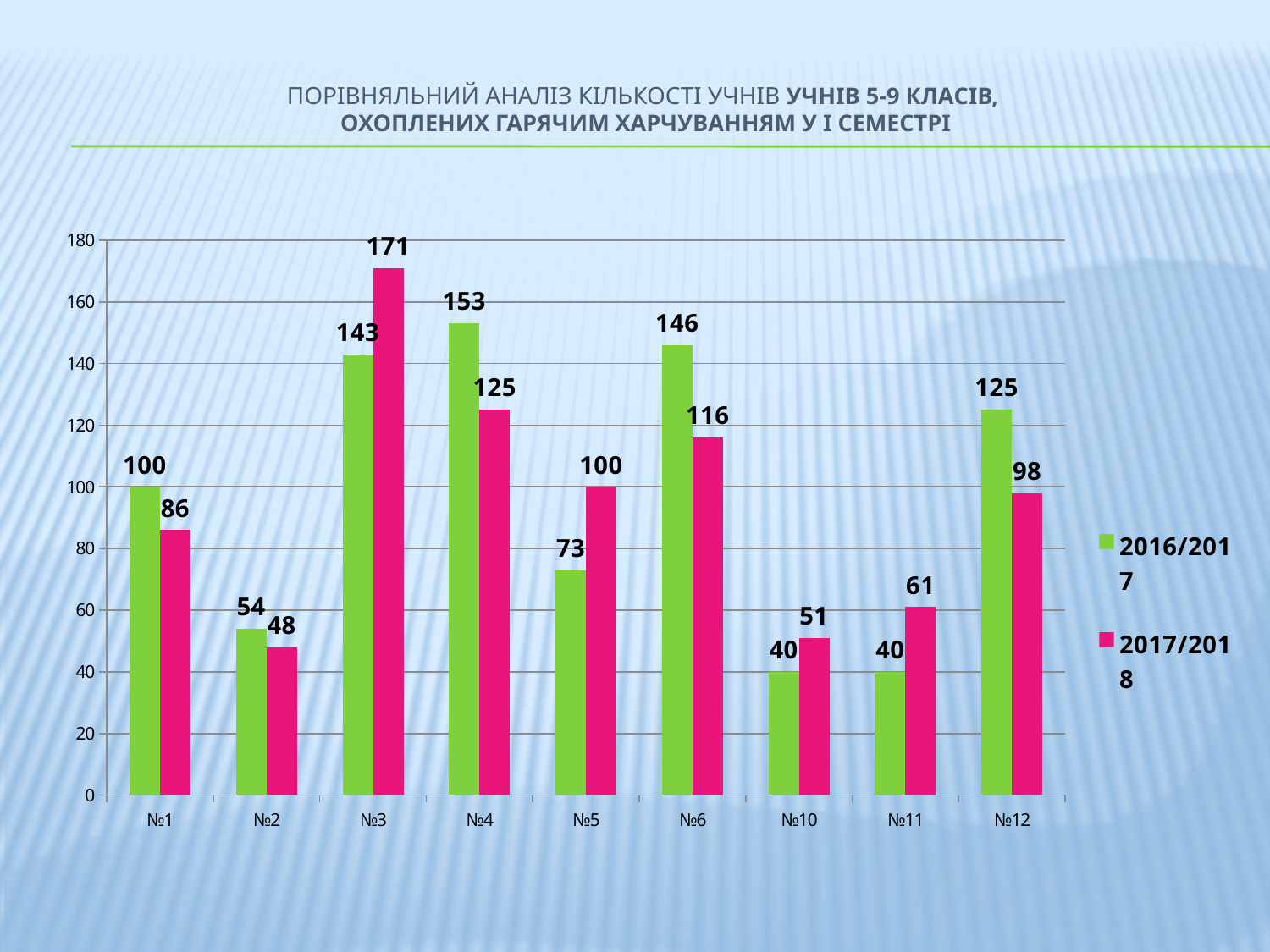
How many categories are shown on the x axis? 9 What kind of chart is shown on the slide? bar chart How many series does the legend list? 2 Which category has the lowest value in the 2017/2018 series? №2 What is the value for №6 in the 2016/2017 series? 146 Which colour represents the 2017/2018 series? pink What is the value for №3 in the 2017/2018 series? 171 What is the value for №12 in the 2017/2018 series? 98 Is the value for №3 in the 2017/2018 series greater or less than 160? greater What is the difference between the 2016/2017 and 2017/2018 values for №4? 28 Which category has the highest value in the 2016/2017 series? №4 Which is larger for №5: the 2016/2017 value or the 2017/2018 value? 2017/2018